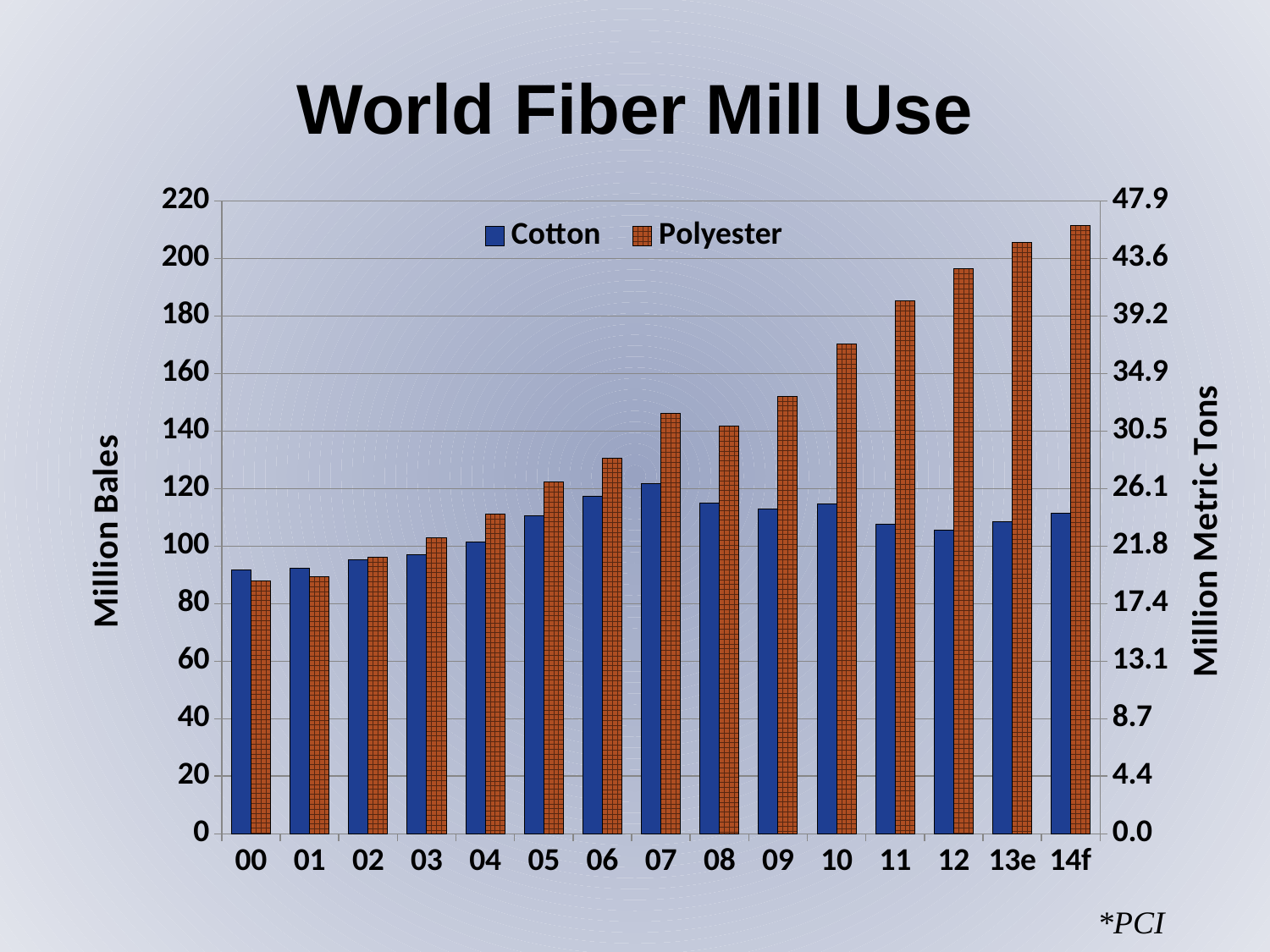
Which is larger, the Cotton value for 06 or the Cotton value for 11? 06 What is the label of the left vertical axis? Million Bales What kind of chart is shown on the slide? bar chart How many series does the legend list? 2 Does the Polyester series generally rise or fall from 00 to 14f? rise In which year is the Polyester bar the highest? 14f Is the Polyester value for 14f greater or less than 43.6 million metric tons? greater Is the Polyester value for 10 greater or less than 34.9 million metric tons? greater What is the title of the chart? World Fiber Mill Use Is the Cotton value for 00 greater or less than 100 million bales? less In which year is the Cotton bar the highest? 07 How many years (categories) are shown on the x axis? 15